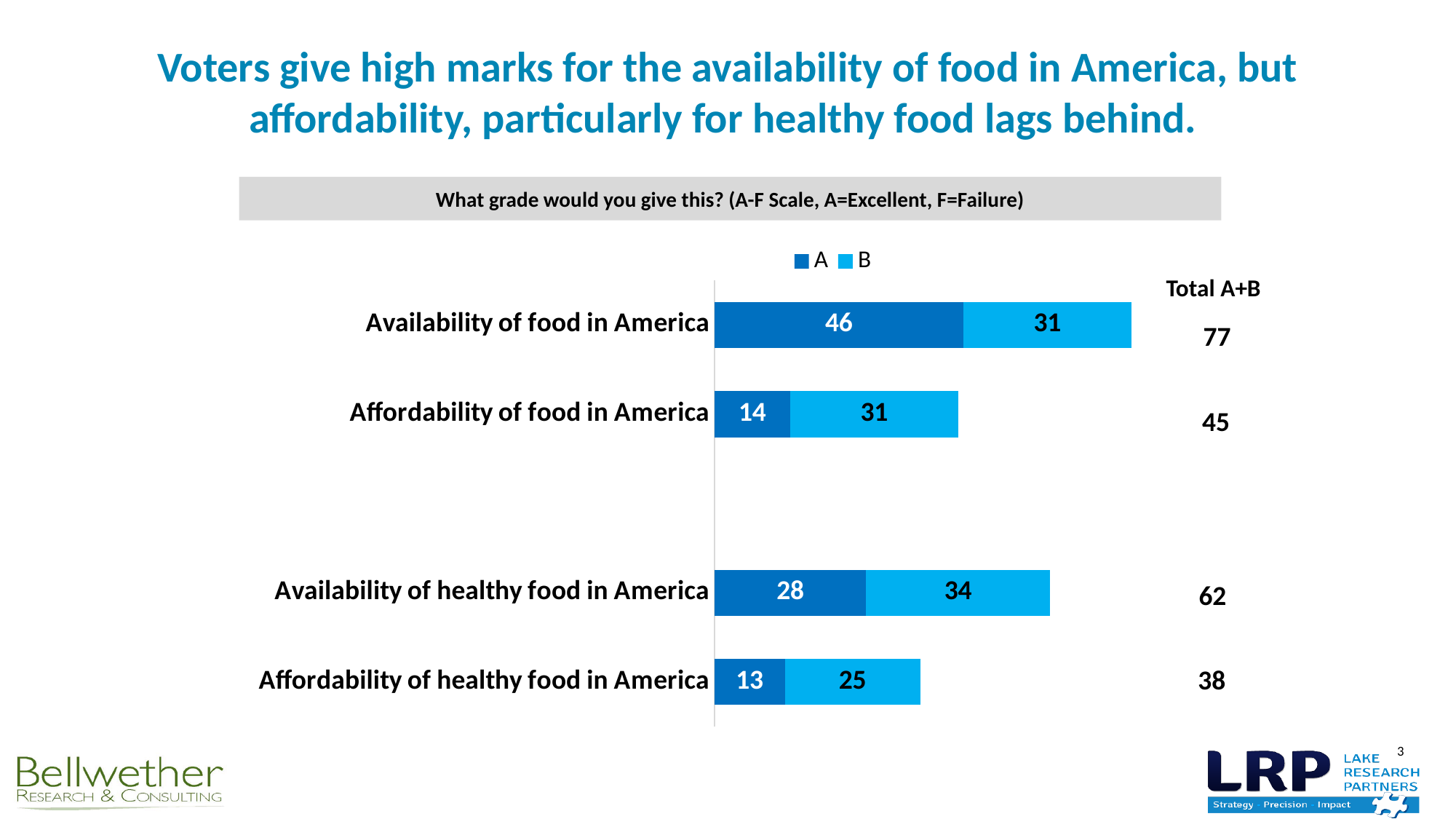
What is the Total A+B for Availability of healthy food in America? 62 What is the difference between the A values for Availability of food in America and Affordability of food in America? 32 How many series does the legend list? 2 Which category has the lowest value for the B series? Affordability of healthy food in America What is the value of the B series for Affordability of healthy food in America? 25 What is the value of the A series for Availability of healthy food in America? 28 Which is larger: the B value for Availability of healthy food in America or the B value for Affordability of food in America? Availability of healthy food in America How many categories are shown in the chart? 4 What is the value of the A series for Availability of food in America? 46 What is the Total A+B for Affordability of food in America? 45 Which category has the highest value for the A series? Availability of food in America What kind of chart is shown on the slide? Stacked bar chart